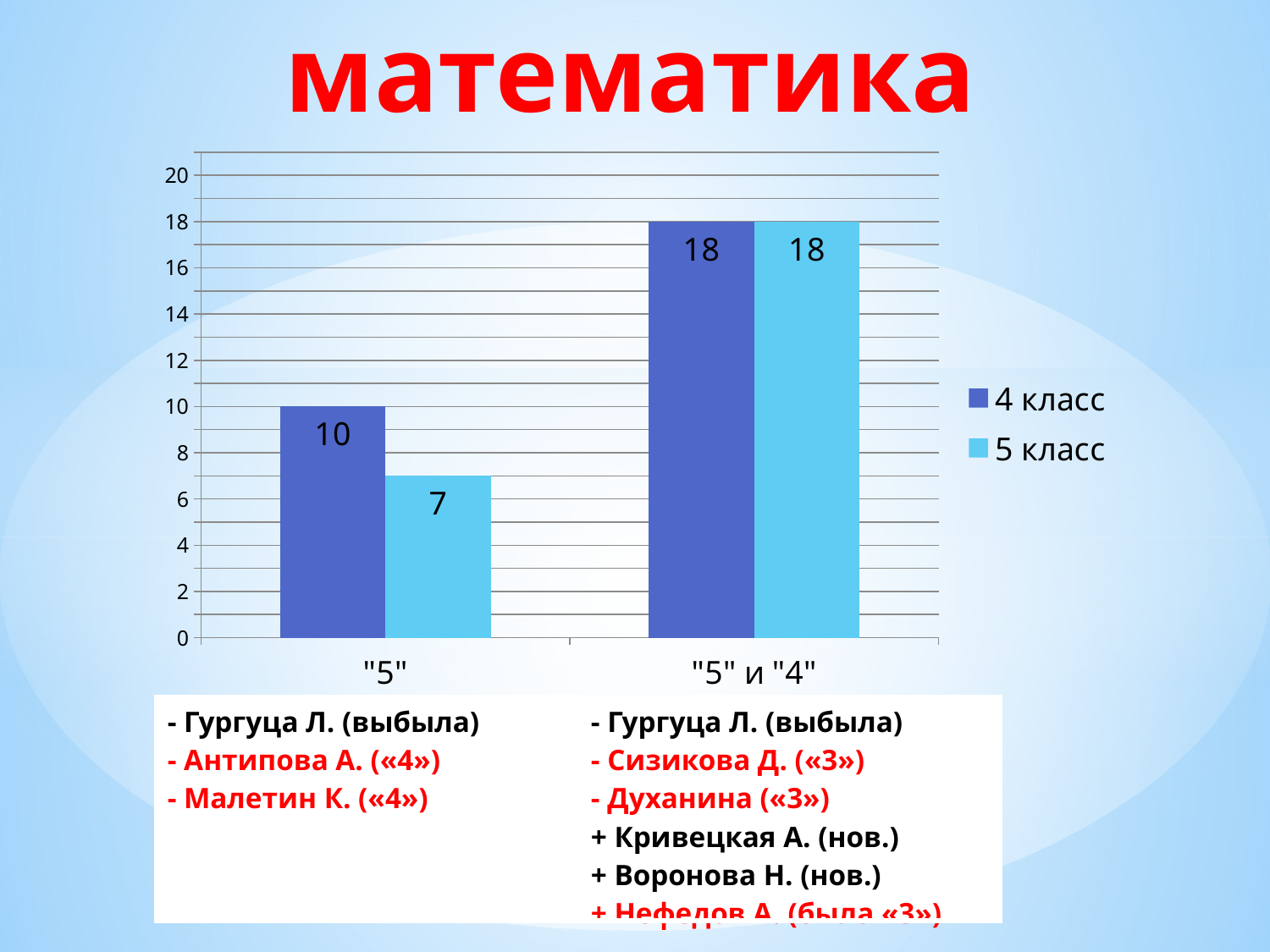
How many categories are shown on the x axis? 2 How many series does the legend list? 2 Which category has the highest value for "4 класс"? "5" и "4" What is the value for "5 класс" in the "5" category? 7 What is the value for "4 класс" in the "5" category? 10 What is the title of the slide above the chart? математика Which category has the lowest value for "5 класс"? "5" What kind of chart is shown on the slide? bar chart What is the difference between the "4 класс" and "5 класс" values in the "5" category? 3 What is the value for "4 класс" in the "5" и "4" category? 18 What is the value for "5 класс" in the "5" и "4" category? 18 Which series has the larger value in the "5" category, "4 класс" or "5 класс"? 4 класс